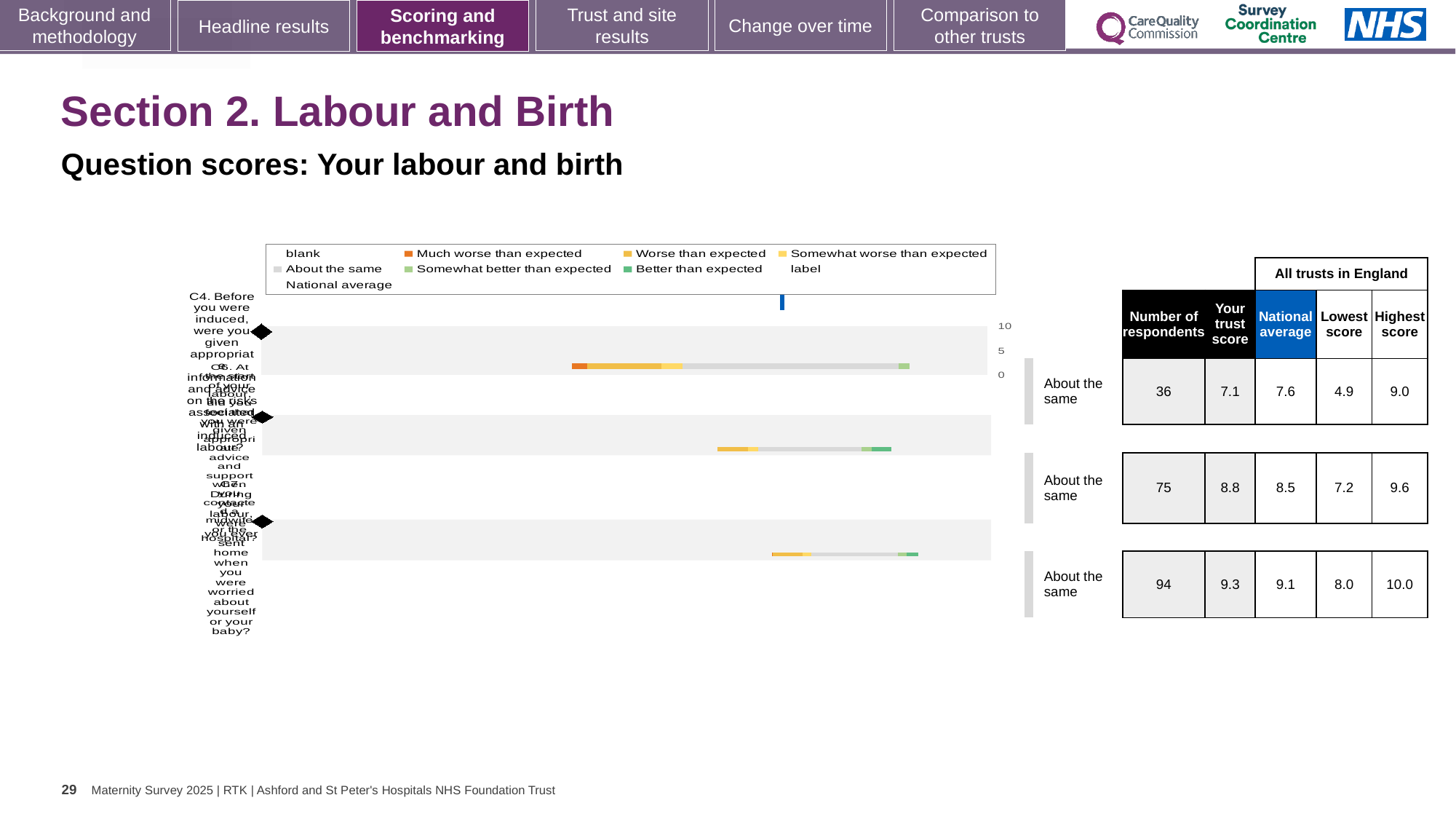
In the table beside the chart, what is the highest score for the third row? 10.0 What benchmark label is shown next to each of the three bars? About the same What is the highest value shown on the chart's axis? 10 Which legend entry is shown in dark orange? Much worse than expected In the table beside the chart, which row has the highest number of respondents? the third row (94) In the table beside the chart, what is the national average for the third row? 9.1 In the table beside the chart, is the trust score in the first row larger or smaller than the national average in that row? smaller In the table beside the chart, what is the trust score for the second row? 8.8 What kind of chart is shown on the slide? bar chart In the table beside the chart, what is the difference between the highest score and the lowest score in the first row? 4.1 In the table beside the chart, what is the number of respondents for the first row? 36 How many horizontal bars are plotted in the chart? 3